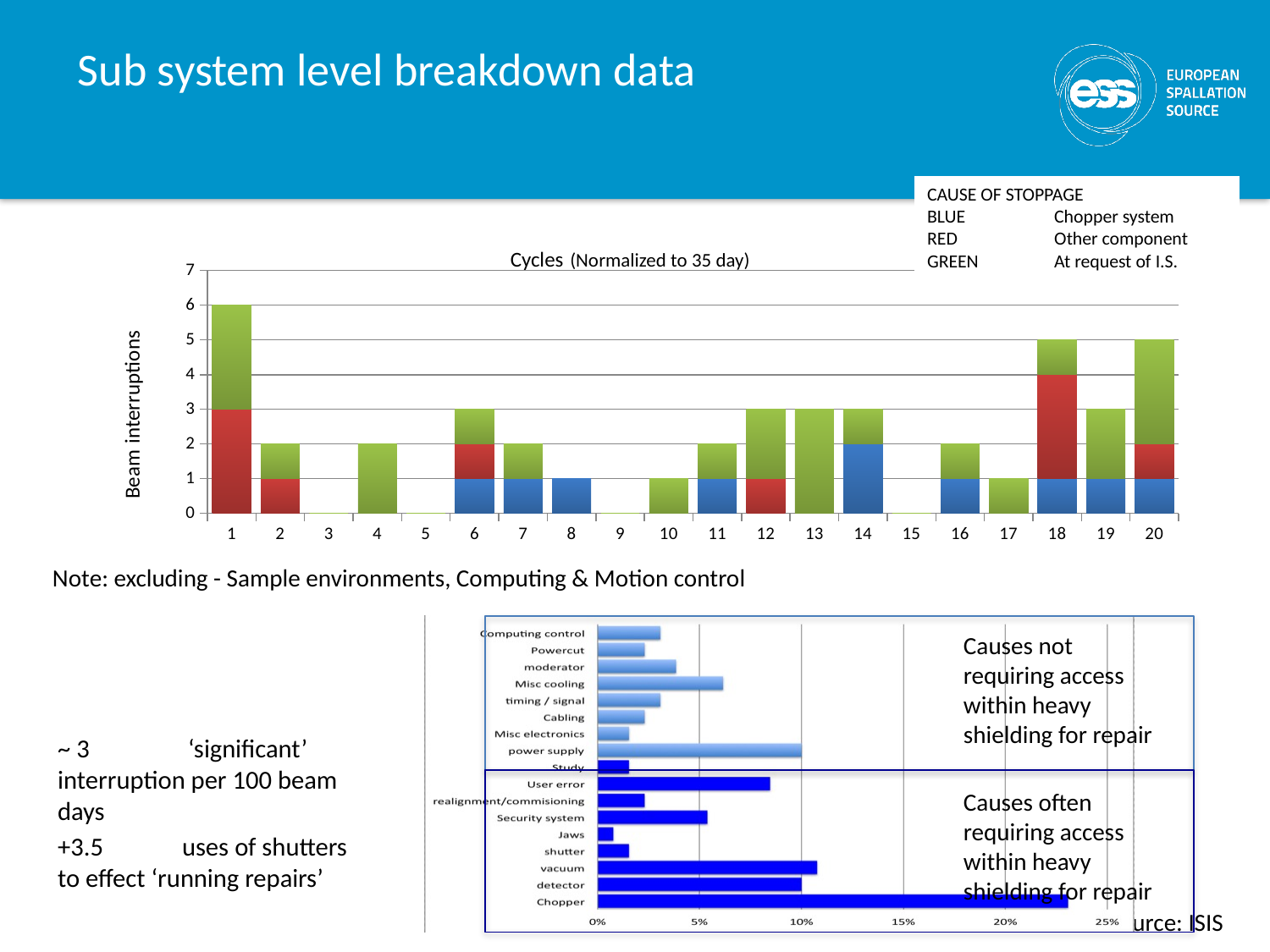
In the bottom chart of causes, which category has the highest value? Chopper In the 'Cycles (Normalized to 35 day)' chart, what is the label of the y axis? Beam interruptions What type of chart is the chart at the bottom of the slide showing causes such as Chopper, detector and vacuum? bar chart What type of chart is the 'Cycles (Normalized to 35 day)' chart? stacked bar chart In the 'Cycles (Normalized to 35 day)' chart, how many cycles are shown on the x axis? 20 In the 'Cycles (Normalized to 35 day)' chart, which has more total beam interruptions, cycle 14 or cycle 17? cycle 14 According to the 'CAUSE OF STOPPAGE' key on the slide, what does the colour blue represent? Chopper system In the bottom chart of causes, is the value for Chopper greater or less than 20%? greater In the 'Cycles (Normalized to 35 day)' chart, what is the total number of beam interruptions in cycle 1? 6 In the 'Cycles (Normalized to 35 day)' chart, what is the total number of beam interruptions in cycle 18? 5 In the 'Cycles (Normalized to 35 day)' chart, what is the total number of beam interruptions in cycle 6? 3 In the 'Cycles (Normalized to 35 day)' chart, which cycle has the highest total number of beam interruptions? 1